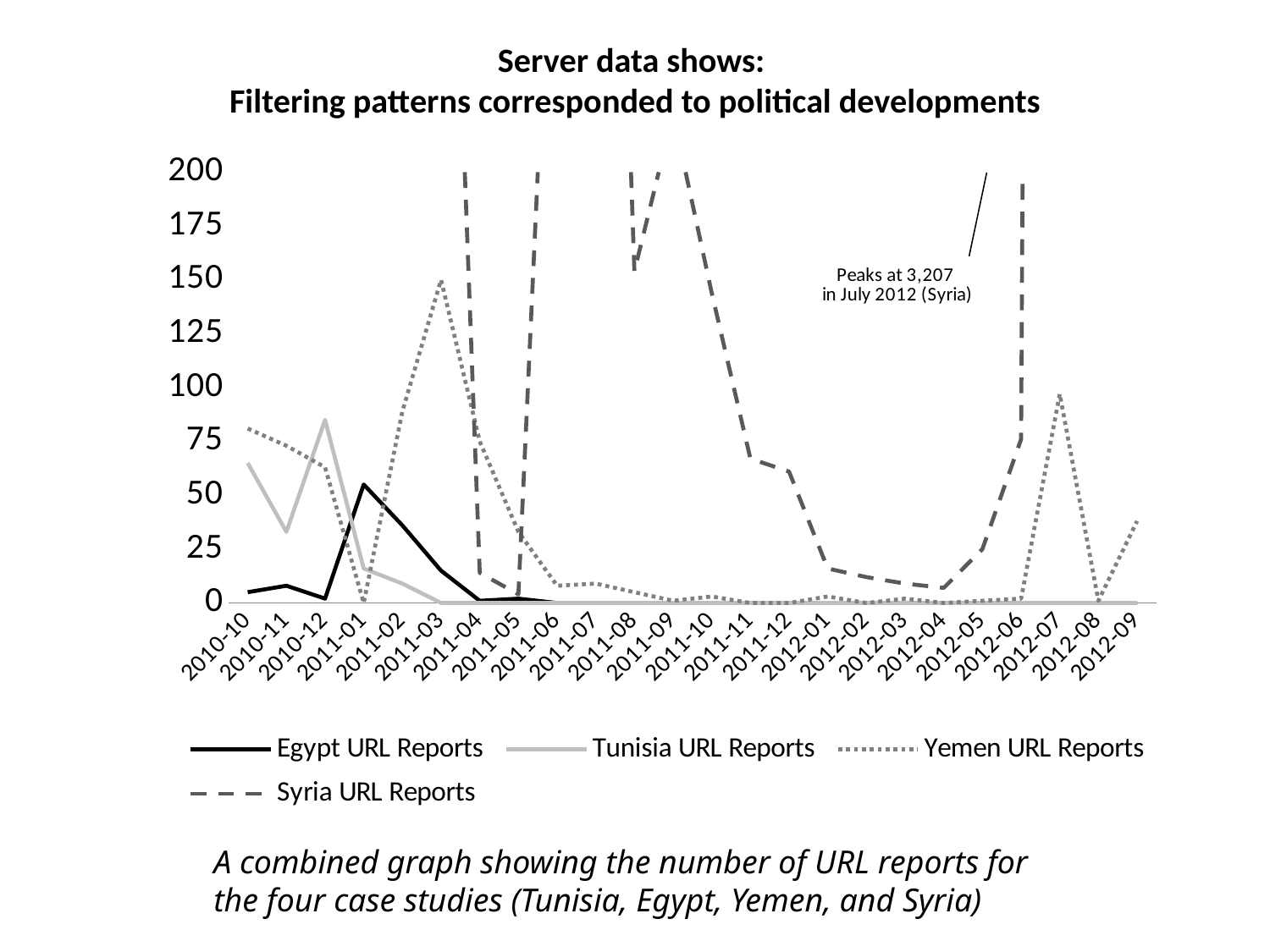
Is the value for Yemen URL Reports in 2011-03 greater or less than 125? greater How many series does the legend list? 4 Does the Syria URL Reports series rise or fall from 2011-10 to 2012-04? fall Which series is drawn with a dotted line? Yemen URL Reports Which series reaches the highest value in the chart? Syria URL Reports Is the value for Egypt URL Reports in 2011-01 greater or less than 25? greater How many months are shown along the x axis? 24 According to the annotation, what value does the Syria URL Reports series peak at in July 2012? 3,207 What is the title of the chart? Server data shows: Filtering patterns corresponded to political developments Is the value for Tunisia URL Reports in 2010-12 greater or less than 75? greater In 2010-10, which is larger: Tunisia URL Reports or Egypt URL Reports? Tunisia URL Reports What kind of chart is shown on the slide? line chart